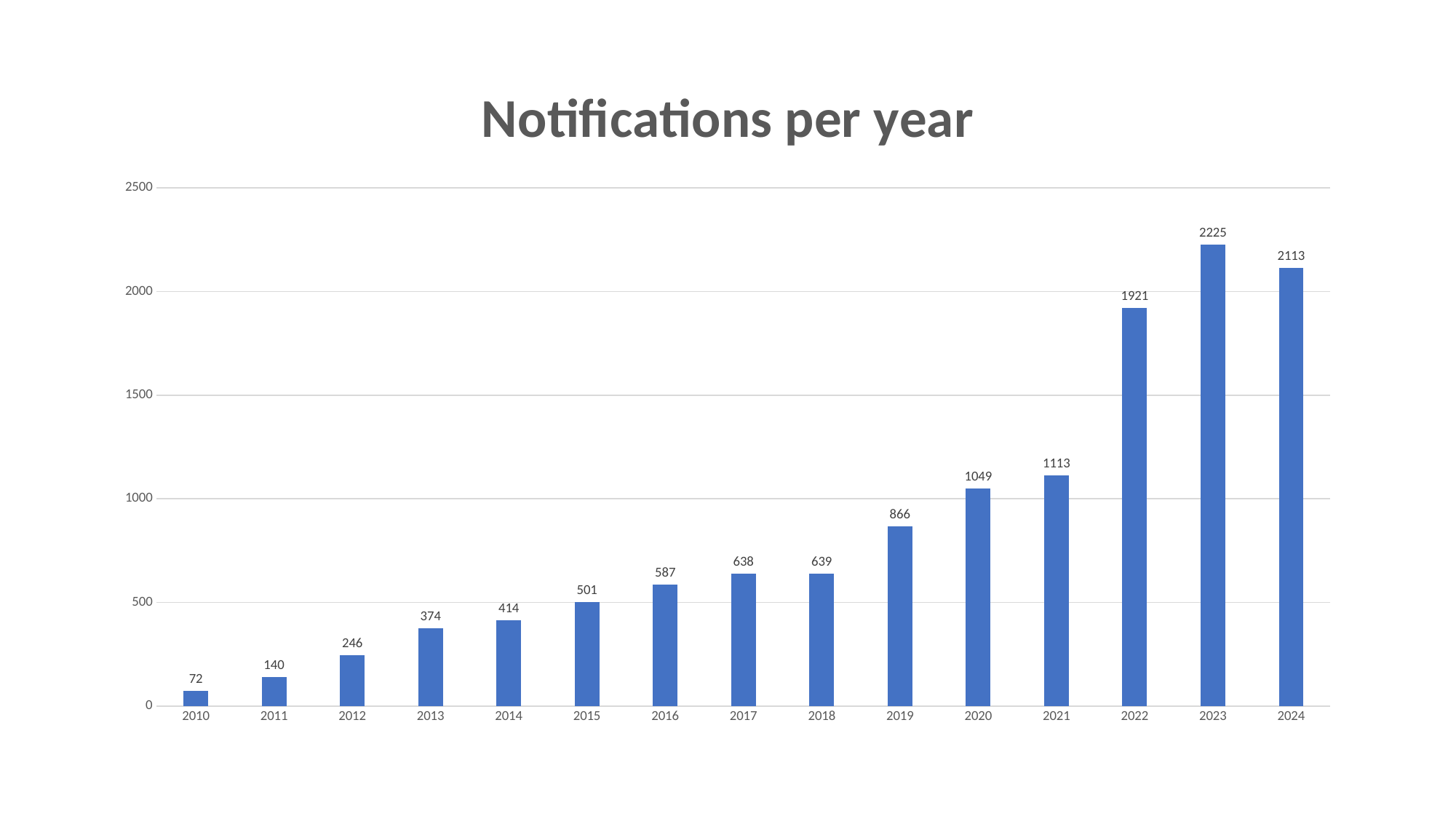
What is the title of the chart? Notifications per year Which year has the highest value? 2023 What is the value for 2010? 72 Which year has the lowest value? 2010 What is the value for 2024? 2113 Which is larger, the value for 2015 or the value for 2016? 2016 What is the difference between the values for 2023 and 2024? 112 What is the difference between the values for 2022 and 2021? 808 What is the value for 2019? 866 How many years are shown on the x axis? 15 What kind of chart is shown? Bar chart Is the value for 2020 greater or less than 1000? greater